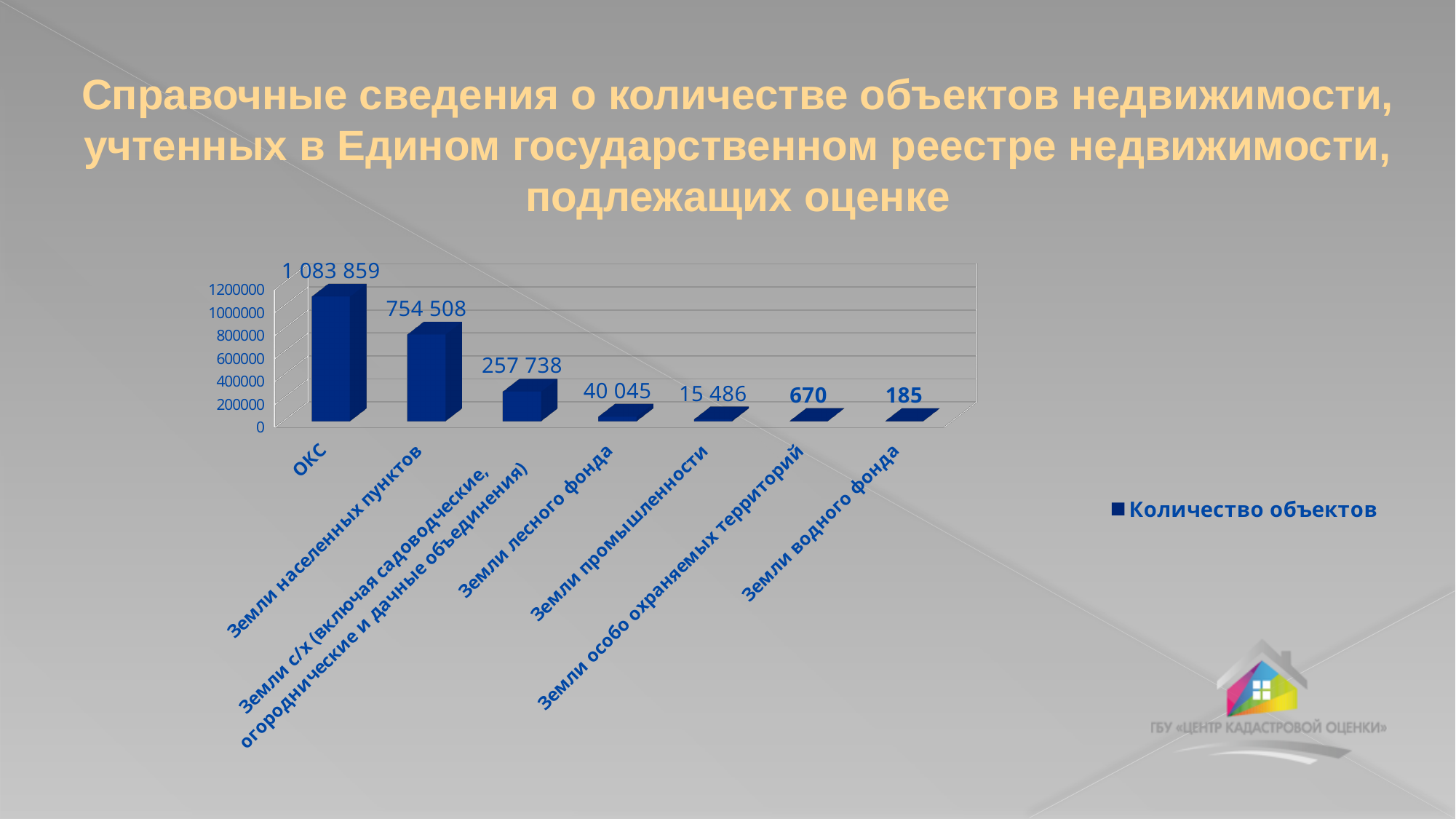
Какое значение показано для категории «Земли лесного фонда»? 40 045 Сколько рядов данных указано в легенде диаграммы? 1 Какое значение показано для категории «Земли водного фонда»? 185 Какого типа эта диаграмма? Столбчатая (bar chart) Сколько категорий показано на диаграмме? 7 Что больше: значение для «Земли промышленности» или для «Земли особо охраняемых территорий»? Земли промышленности На сколько значение для «Земли населенных пунктов» больше значения для «Земли с/х (включая садоводческие, огороднические и дачные объединения)»? 496 770 Какая категория имеет наибольшее значение на диаграмме? ОКС Какое значение показано для категории «Земли населенных пунктов»? 754 508 Какая категория имеет наименьшее значение на диаграмме? Земли водного фонда Как называется ряд данных в легенде диаграммы? Количество объектов Какое значение показано для категории «ОКС»? 1 083 859